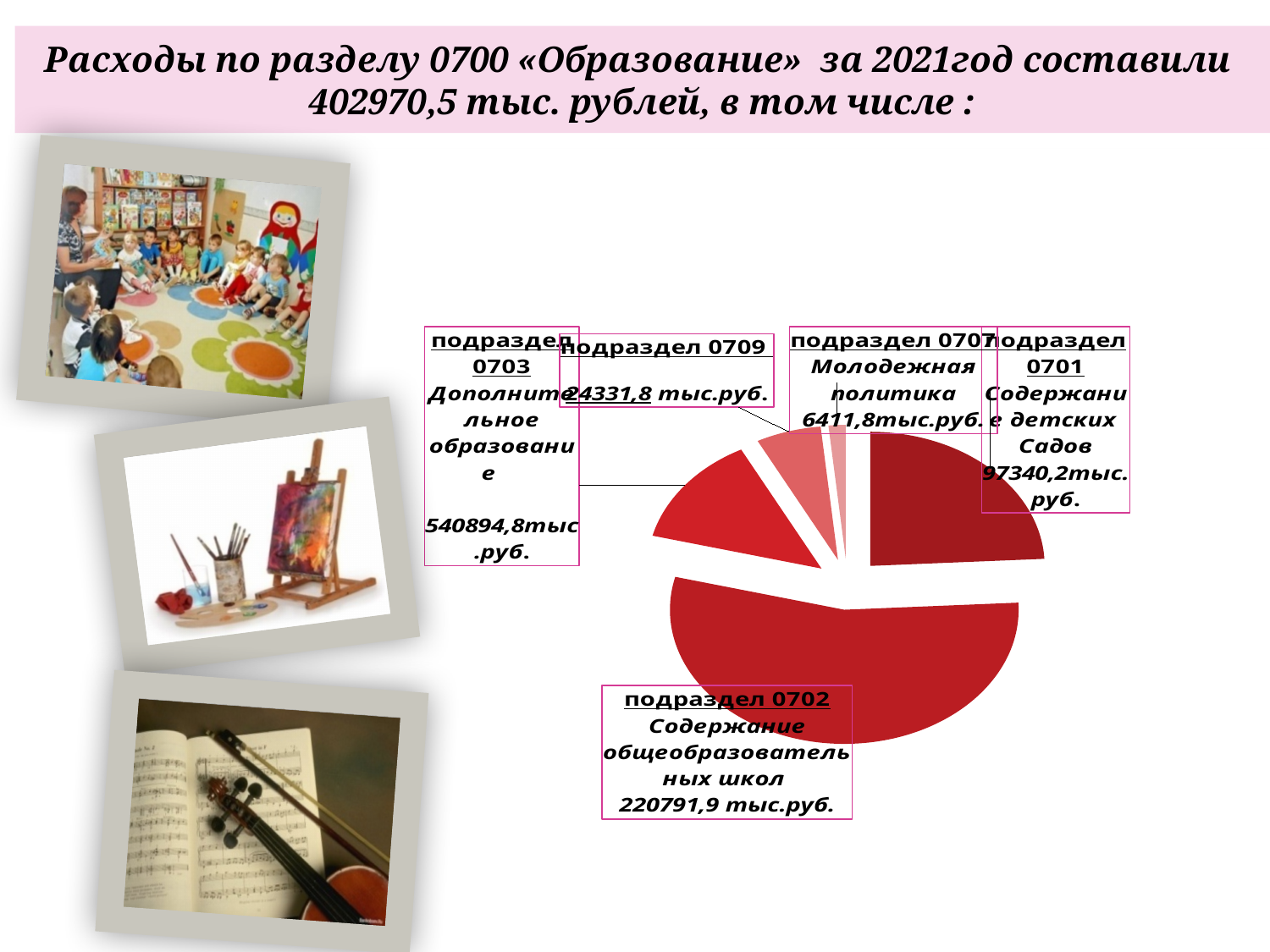
What is the value shown for подраздел 0701 (Содержание детских садов)? 97340,2 тыс.руб. According to the slide title, what were the total expenditures under section 0700 «Образование» for 2021? 402970,5 тыс. рублей What is the value shown for подраздел 0703 (Дополнительное образование)? 540894,8 тыс.руб. What is the difference between the values for подраздел 0702 and подраздел 0701? 123451,7 тыс.руб. Which is larger: the value for подраздел 0701 or подраздел 0709? подраздел 0701 What is the difference between the values for подраздел 0709 and подраздел 0707? 17920 тыс.руб. What is the value shown for подраздел 0702 (Содержание общеобразовательных школ)? 220791,9 тыс.руб. What is the value shown for подраздел 0709? 24331,8 тыс.руб. What is the value shown for подраздел 0707 (Молодежная политика)? 6411,8 тыс.руб. Which subsection has the smallest value in the pie chart? подраздел 0707 (Молодежная политика) What kind of chart is shown on the slide? pie chart How many slices (subsections) does the pie chart show? 5